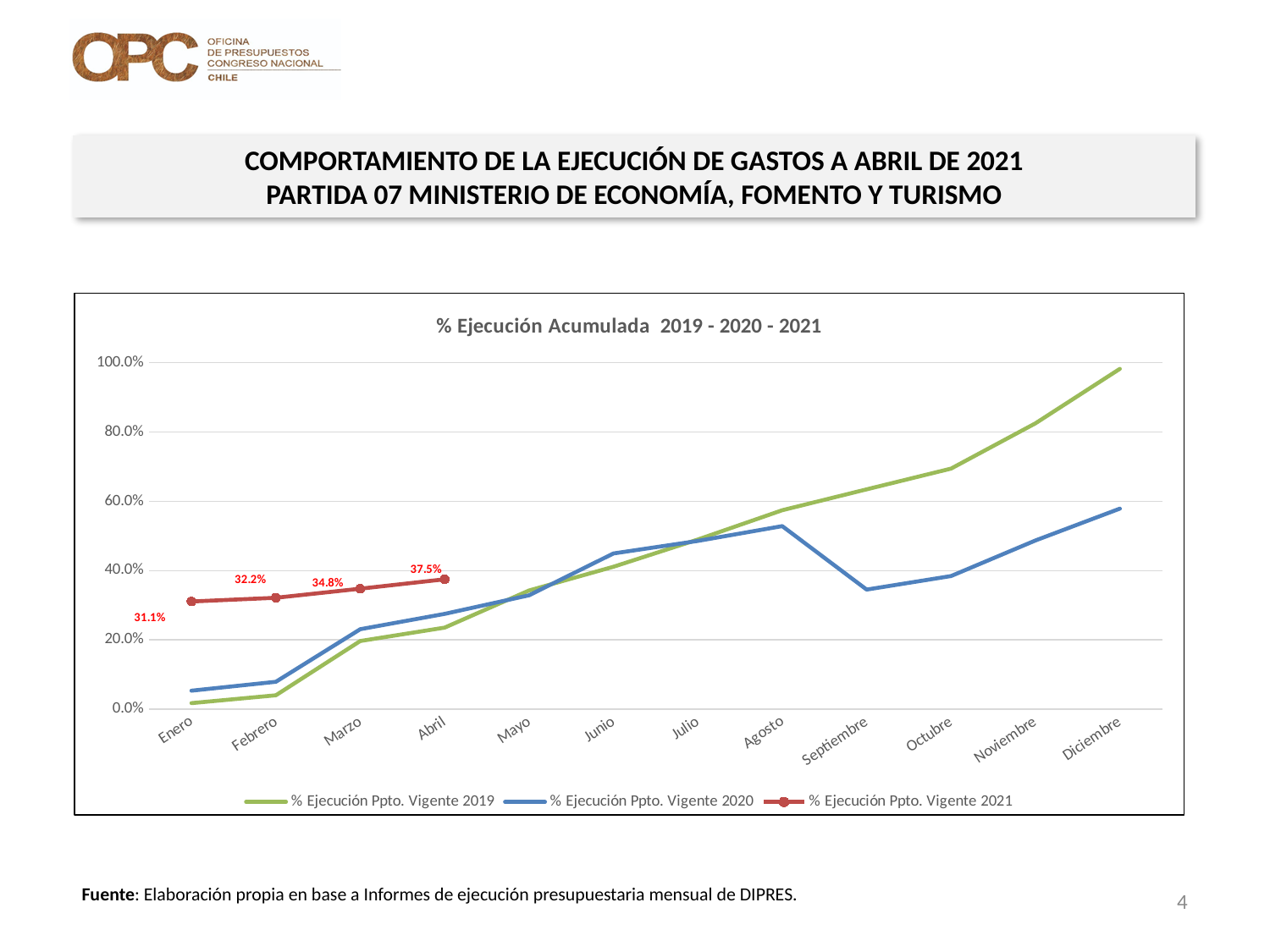
By how many percentage points did % Ejecución Ppto. Vigente 2021 increase from Enero to Abril? 6.4 percentage points What kind of chart is shown on the slide? Line chart What is the value of % Ejecución Ppto. Vigente 2021 in Marzo? 34.8% How many months are shown along the x axis of the chart? 12 In Diciembre, which series has the higher value: % Ejecución Ppto. Vigente 2019 or % Ejecución Ppto. Vigente 2020? % Ejecución Ppto. Vigente 2019 Does the % Ejecución Ppto. Vigente 2021 series rise or fall from Enero to Abril? Rise How many series does the chart legend list? 3 What is the title of the chart? % Ejecución Acumulada 2019 - 2020 - 2021 What is the value of % Ejecución Ppto. Vigente 2021 in Abril? 37.5% Is the value for % Ejecución Ppto. Vigente 2019 in Diciembre greater or less than 80.0%? greater Is the value for % Ejecución Ppto. Vigente 2020 in Septiembre greater or less than 40.0%? less What is the value of % Ejecución Ppto. Vigente 2021 in Enero? 31.1%